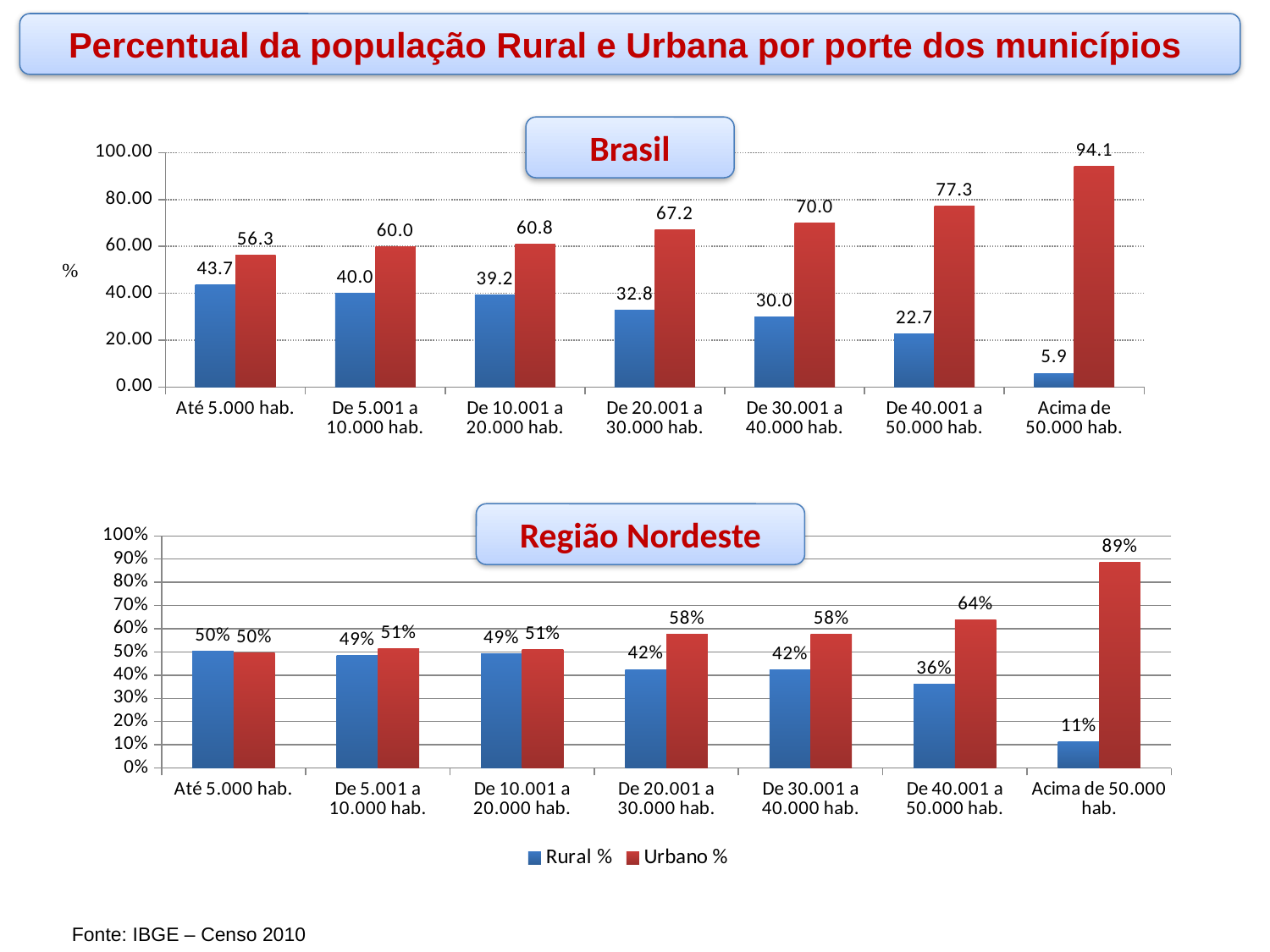
In the Brasil chart, how many municipality size categories are shown? 7 In the Região Nordeste chart, what is the Urbano % value for 'De 20.001 a 30.000 hab.'? 58% In the Brasil chart, does the Rural value rise or fall as municipality size increases along the x axis? Fall What type of chart is the Região Nordeste chart? Bar chart In the Brasil chart, which municipality size category has the lowest Rural value? Acima de 50.000 hab. In the Região Nordeste chart, which category has the highest Urbano % value? Acima de 50.000 hab. In the Brasil chart, what is the value of the blue (Rural) bar for 'De 20.001 a 30.000 hab.'? 32.8 How many series does the legend of the Região Nordeste chart list? 2 In the Região Nordeste chart, what is the Rural % value for 'De 40.001 a 50.000 hab.'? 36% In the Brasil chart, what is the difference between the Urbano and Rural values for 'Até 5.000 hab.'? 12.6 In the Região Nordeste chart, what is the difference between Urbano % and Rural % for 'Acima de 50.000 hab.'? 78% In the Brasil chart, what is the Urbano value for municipalities 'Acima de 50.000 hab.'? 94.1